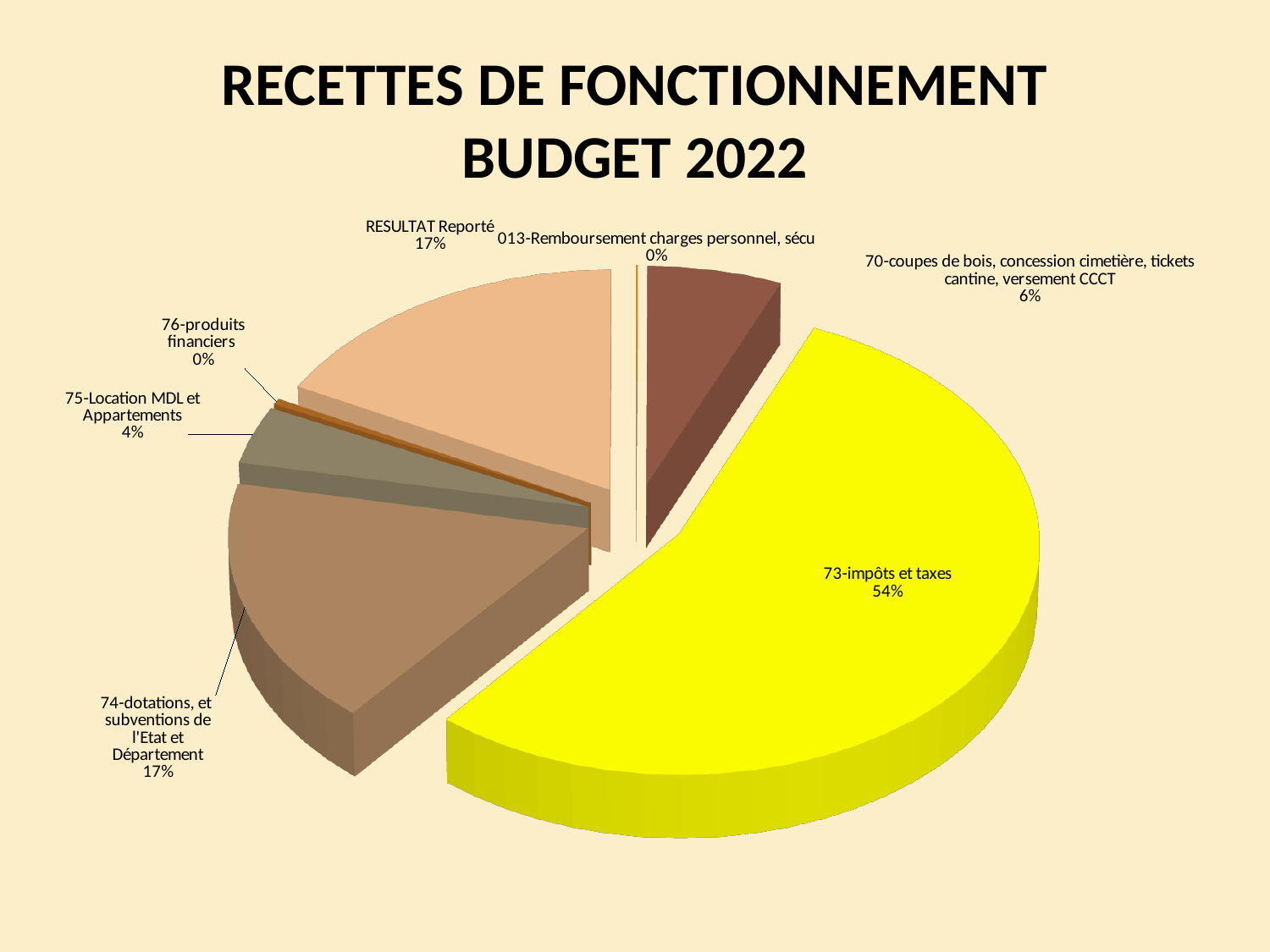
What percentage is shown for "74-dotations, et subventions de l'Etat et Département"? 17% What is the difference in percentage points between "73-impôts et taxes" and "RESULTAT Reporté"? 37 percentage points How many categories are shown in the pie chart? 7 What share of the pie does "73-impôts et taxes" represent? 54% What kind of chart is shown on the slide? pie chart Which category has the largest share of the pie? 73-impôts et taxes What percentage is shown for "76-produits financiers"? 0% Which is larger: the share for "70-coupes de bois, concession cimetière, tickets cantine, versement CCCT" or for "75-Location MDL et Appartements"? 70-coupes de bois, concession cimetière, tickets cantine, versement CCCT What is the title of the chart? RECETTES DE FONCTIONNEMENT BUDGET 2022 What percentage is shown for "75-Location MDL et Appartements"? 4% What percentage is shown for "RESULTAT Reporté"? 17% What percentage is shown for "70-coupes de bois, concession cimetière, tickets cantine, versement CCCT"? 6%